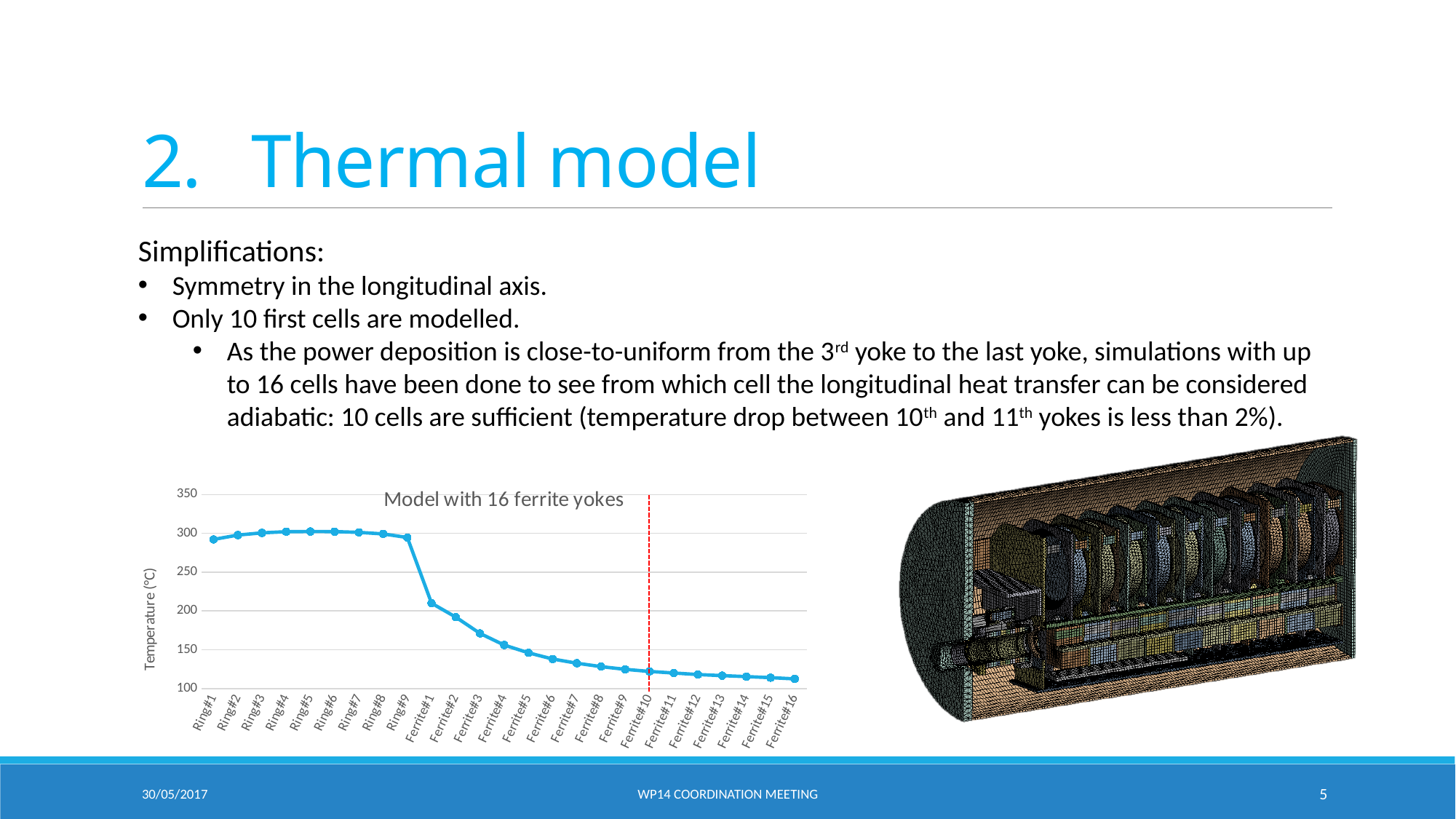
What kind of chart is shown on the slide? line chart Is the temperature for Ferrite#16 greater or less than 150? less What is the label of the vertical axis of the chart? Temperature (°C) Is the temperature for Ferrite#3 greater or less than 200? less Is the temperature for Ferrite#1 greater or less than 200? greater How many data points are plotted along the x axis of the chart? 25 Does the temperature rise or fall from Ferrite#1 to Ferrite#16? fall What is the title of the chart? Model with 16 ferrite yokes Which has the higher temperature, Ring#9 or Ferrite#1? Ring#9 Which has the higher temperature, Ferrite#1 or Ferrite#3? Ferrite#1